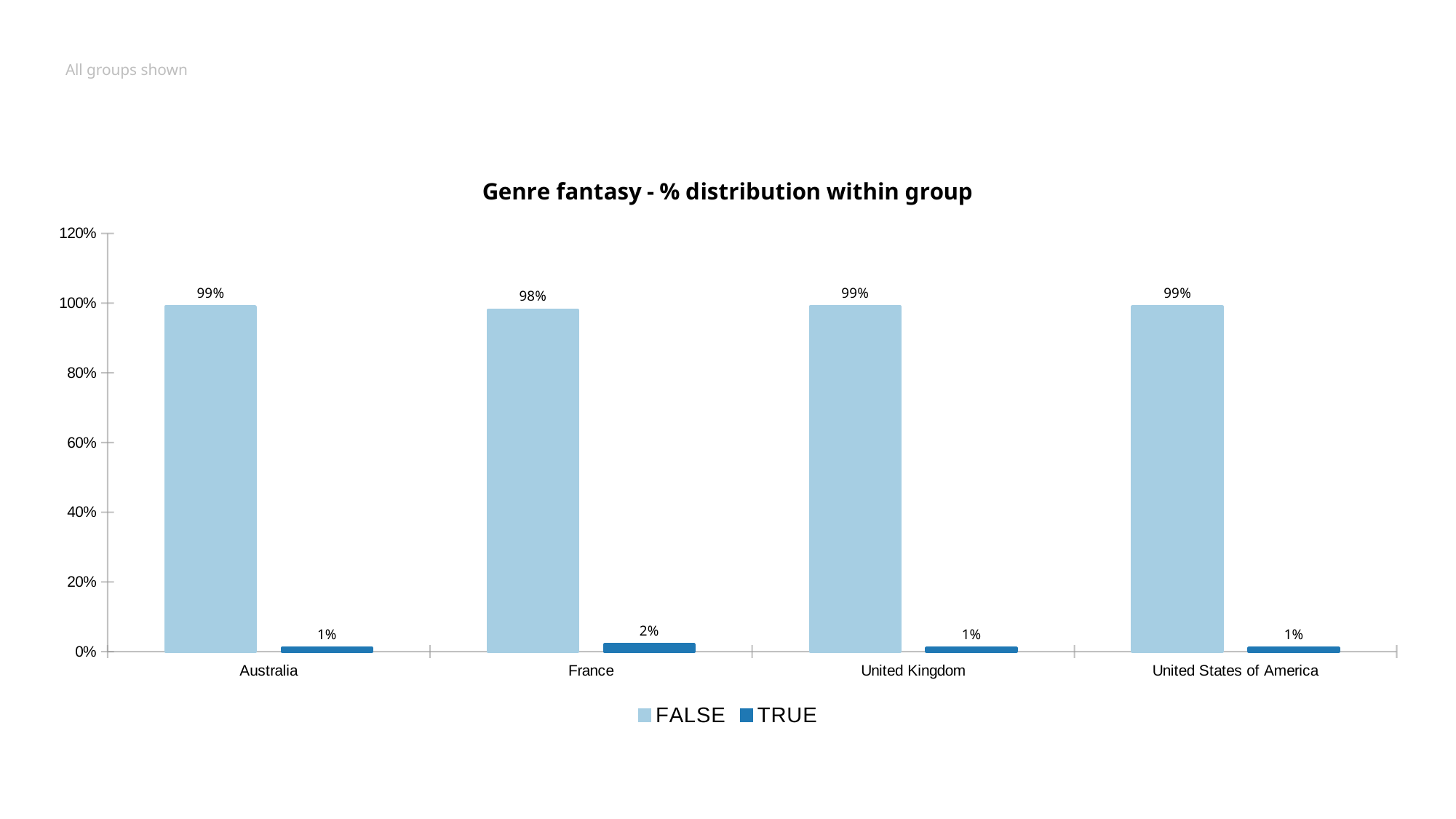
Which country has the highest TRUE value? France What is the TRUE value for Australia? 1% How many countries are shown on the x axis? 4 What is the FALSE value for United Kingdom? 99% How many series does the legend list? 2 Which country has the lowest FALSE value? France Is the FALSE value for Australia larger than the TRUE value for Australia? Yes What kind of chart is shown on the slide? Bar chart What is the TRUE value for France? 2% What is the FALSE value for France? 98% Is the FALSE value for United States of America greater or less than 80%? greater What is the difference between the FALSE and TRUE values for France? 96%